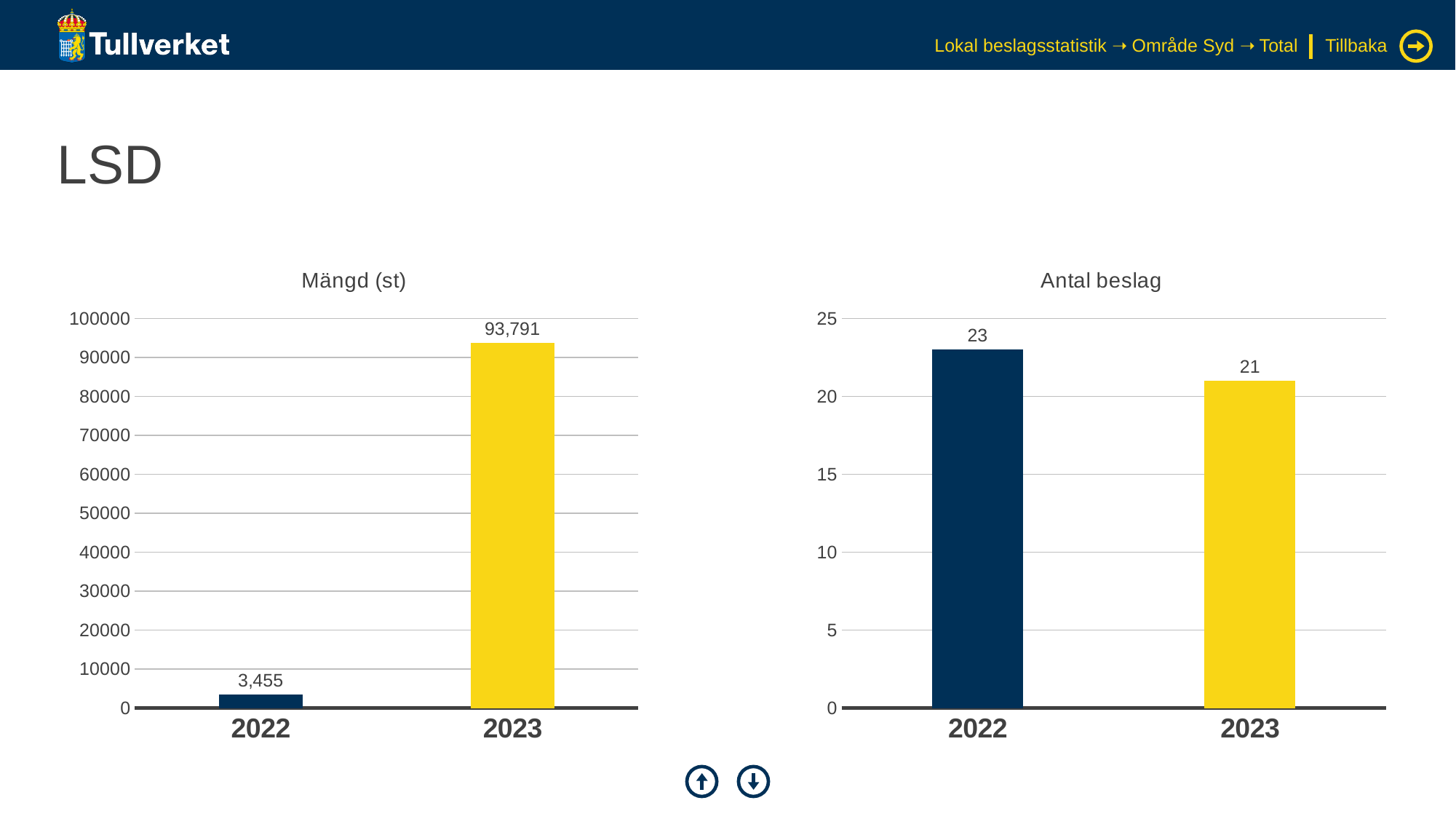
In the 'Antal beslag' chart, which is larger, the value for 2022 or 2023? 2022 In the 'Mängd (st)' chart, what is the value for 2023? 93,791 What kind of chart is the 'Antal beslag' chart? bar chart In the 'Antal beslag' chart, do the values rise or fall from 2022 to 2023? fall In the 'Antal beslag' chart, what is the value for 2023? 21 In the 'Mängd (st)' chart, which year has the highest value? 2023 In the 'Antal beslag' chart, what is the value for 2022? 23 In the 'Mängd (st)' chart, what is the difference between the 2023 and 2022 values? 90,336 In the 'Mängd (st)' chart, what is the value for 2022? 3,455 In the 'Antal beslag' chart, which year has the lowest value? 2023 In the 'Mängd (st)' chart, is the value for 2023 greater or less than 90000? greater In the 'Antal beslag' chart, what is the difference between the 2022 and 2023 values? 2